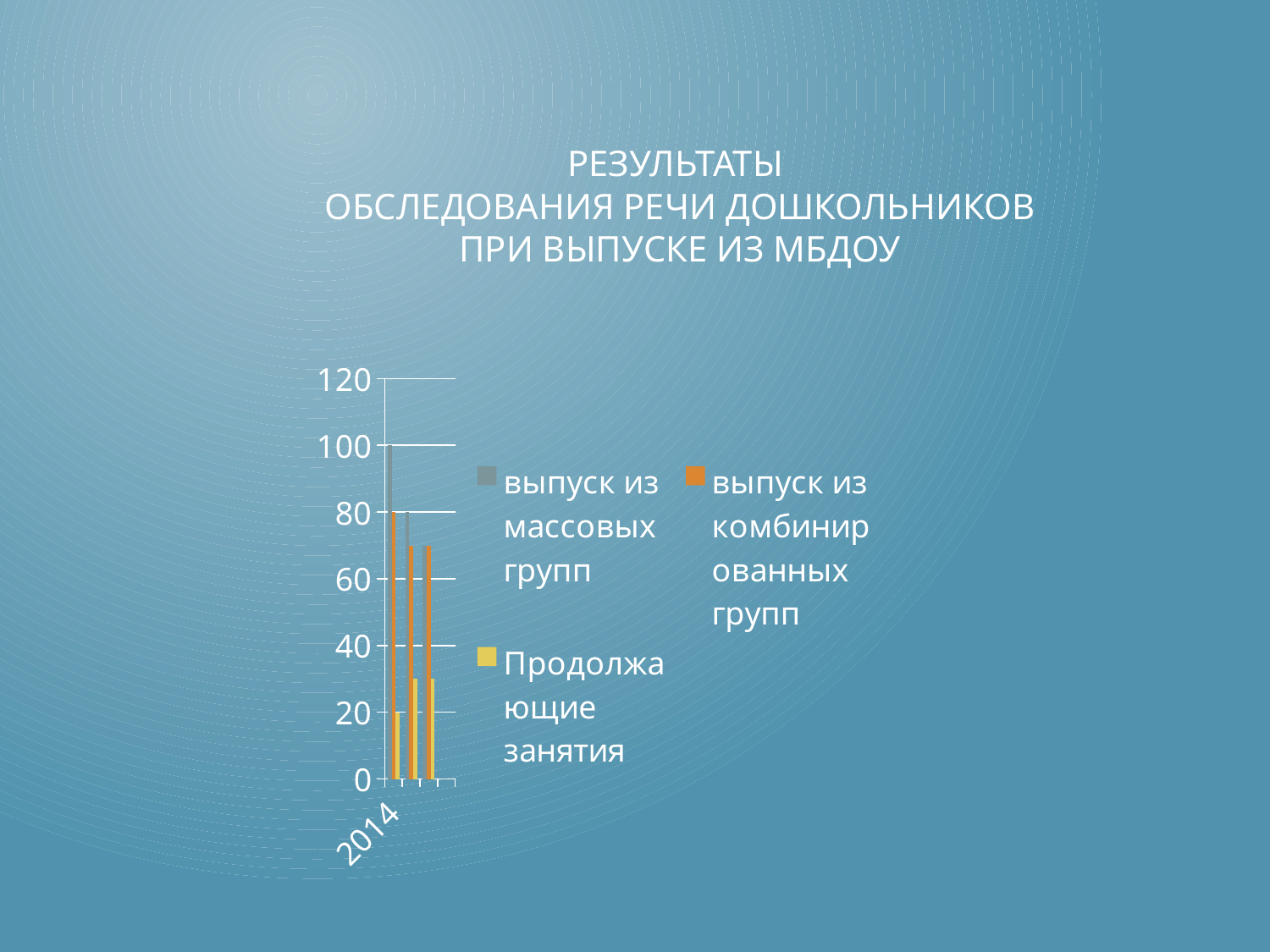
Is the value for 'Продолжающие занятия' in 2014 greater or less than 40? less In 2014, which is larger: 'выпуск из комбинированных групп' or 'Продолжающие занятия'? выпуск из комбинированных групп Which series is shown in orange in the legend? выпуск из комбинированных групп Which series has the lowest value in 2014? Продолжающие занятия What is the highest value shown on the vertical axis? 120 What kind of chart is shown on the slide? bar chart Is the value for 'выпуск из комбинированных групп' in 2014 greater or less than 60? greater How many series does the chart legend list? 3 What is the title shown above the chart? РЕЗУЛЬТАТЫ ОБСЛЕДОВАНИЯ РЕЧИ ДОШКОЛЬНИКОВ ПРИ ВЫПУСКЕ ИЗ МБДОУ